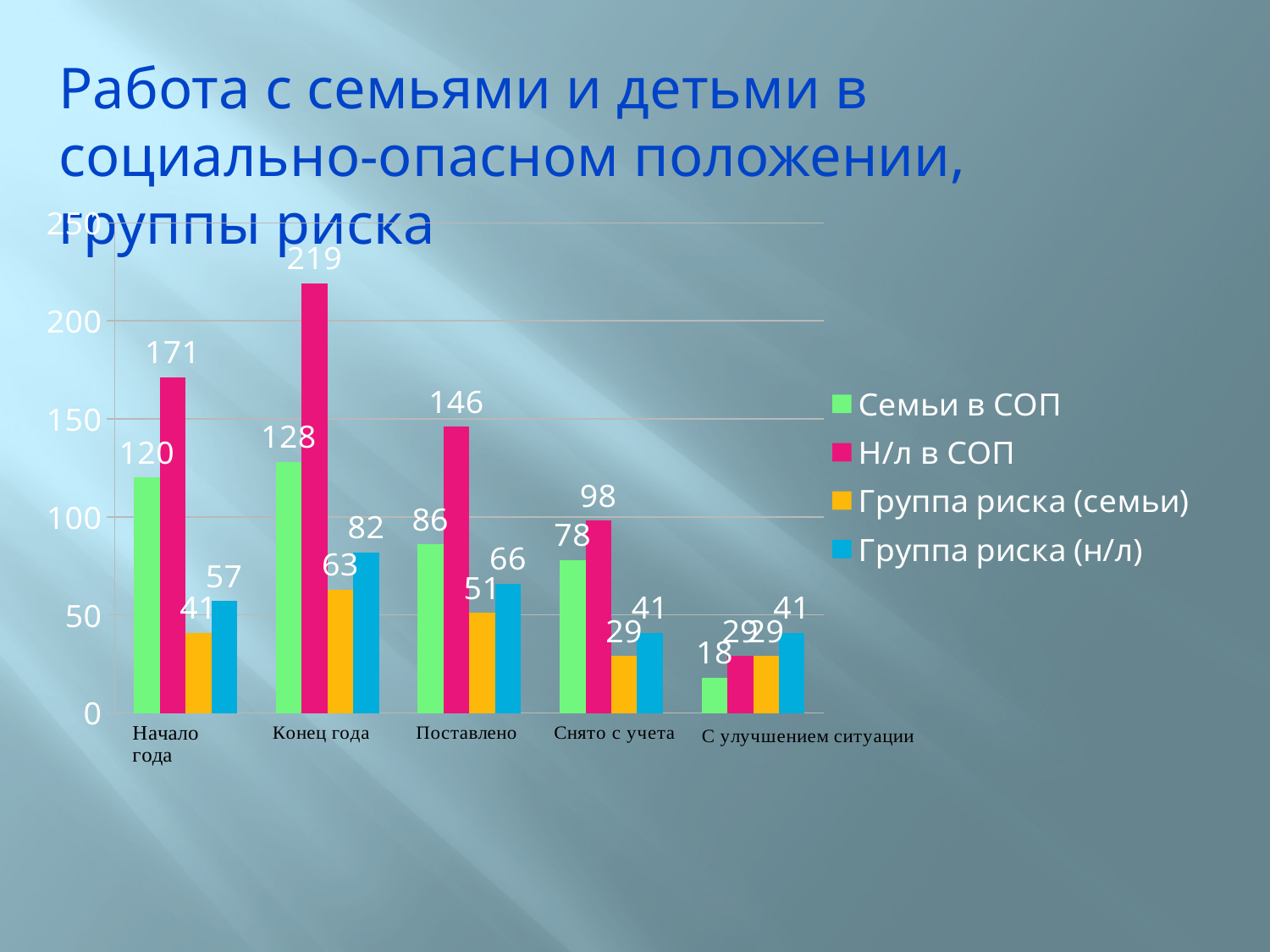
Which is larger: Группа риска (н/л) for Конец года or Группа риска (семьи) for Конец года? Группа риска (н/л) for Конец года What is the value of Группа риска (семьи) for Снято с учета? 29 What type of chart is shown on the slide? bar chart What is the value of Группа риска (н/л) for Поставлено? 66 What is the value of Семьи в СОП for Начало года? 120 Which category has the highest value for Н/л в СОП? Конец года Which category has the lowest value for Семьи в СОП? С улучшением ситуации How many series does the legend list? 4 What is the difference between Н/л в СОП for Конец года and Н/л в СОП for Начало года? 48 How many categories are shown along the x axis? 5 Which series is shown in pink in the legend? Н/л в СОП What is the value of Н/л в СОП for Конец года? 219